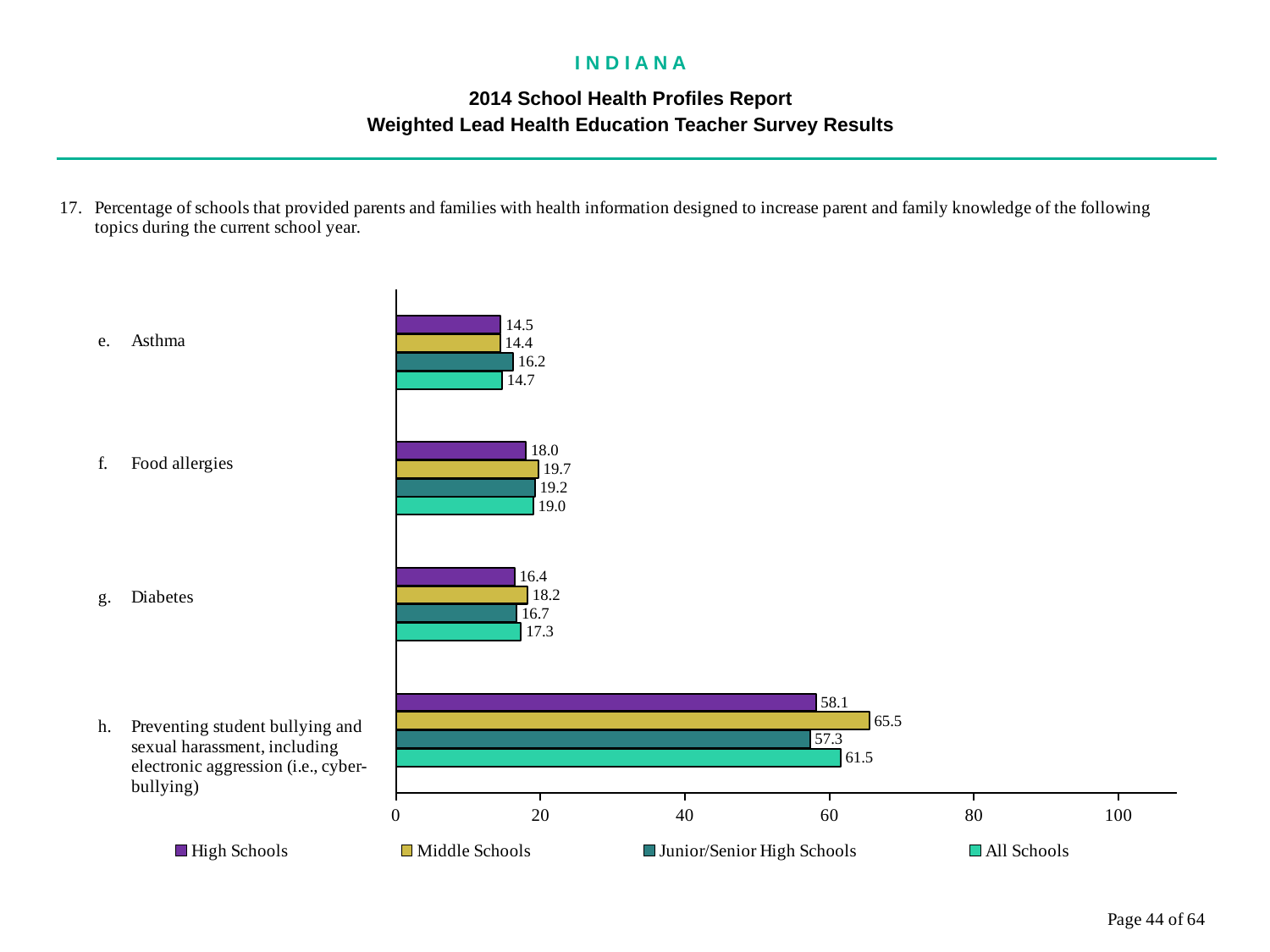
What is the High Schools value for Diabetes? 16.4 Is the All Schools value for Preventing student bullying and sexual harassment greater or less than 60? greater Which is larger for Diabetes: the Middle Schools value or the All Schools value? Middle Schools What is the value for Junior/Senior High Schools for Asthma? 16.2 How many topics (categories) are shown in the chart? 4 Which topic has the highest values across all school types? Preventing student bullying and sexual harassment, including electronic aggression (i.e., cyber-bullying) What is the value for Middle Schools for Preventing student bullying and sexual harassment? 65.5 How many series does the legend list? 4 What is the All Schools value for Food allergies? 19.0 What is the difference between the Middle Schools and High Schools values for Preventing student bullying and sexual harassment? 7.4 What type of chart is shown on the slide? Bar chart Which school type has the lowest value for Preventing student bullying and sexual harassment? Junior/Senior High Schools